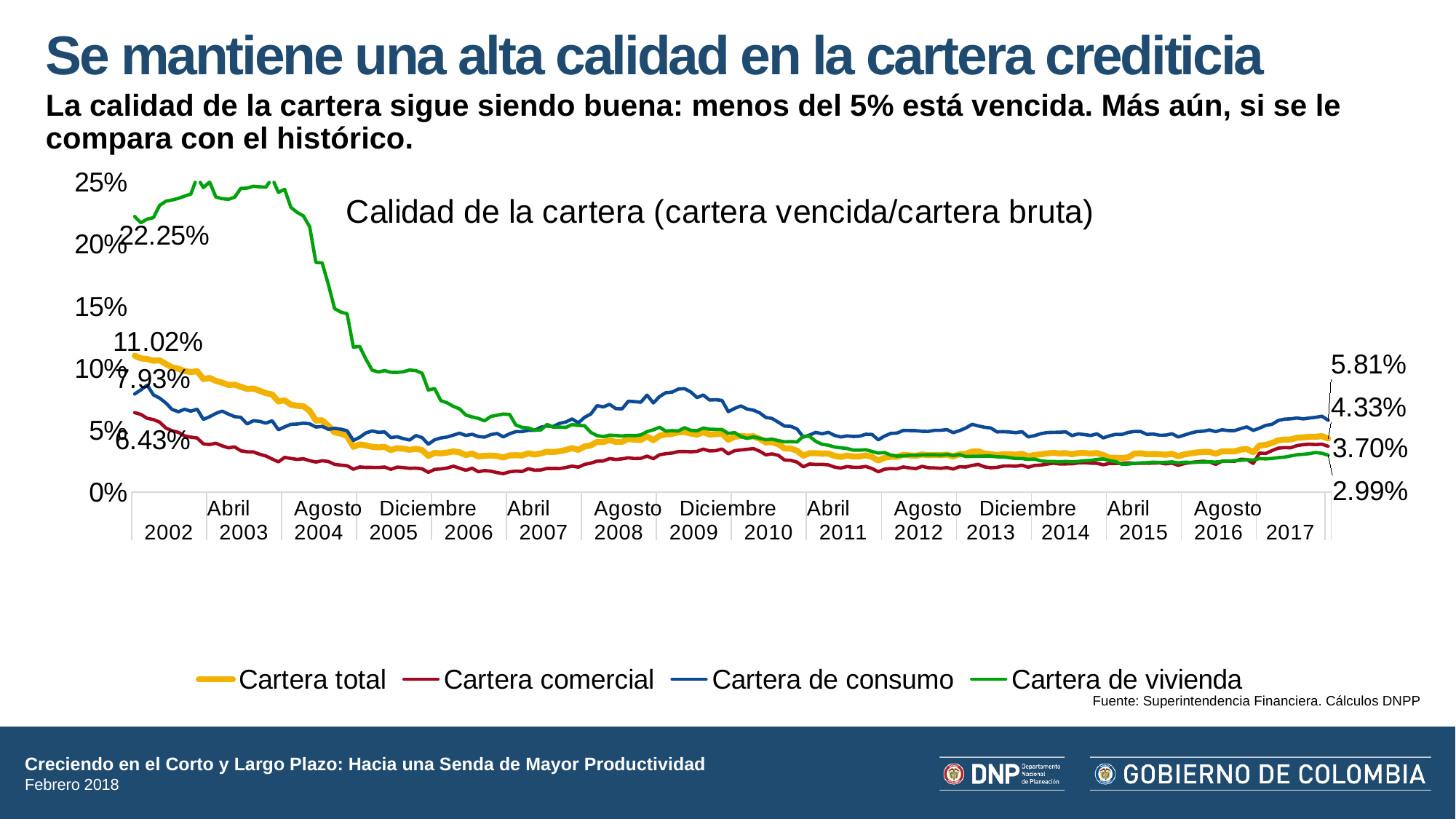
What is the value labelled at the end of the Cartera de vivienda series? 2.99% What is the title of the chart? Calidad de la cartera (cartera vencida/cartera bruta) At the start of the chart, which is larger: Cartera de consumo (7.93%) or Cartera comercial (6.43%)? Cartera de consumo How many series does the legend of the chart list? 4 Is the peak value of the Cartera de vivienda series around 2003 greater or less than 20%? greater What is the value labelled at the end of the Cartera de consumo series? 5.81% What is the value labelled at the start of the Cartera total series? 11.02% What is the value labelled at the start of the Cartera de vivienda series? 22.25% Which series has the lowest value at the end of the chart (2017)? Cartera de vivienda Which series has the highest value at the end of the chart (2017)? Cartera de consumo By how many percentage points did the Cartera de vivienda series fall from its labelled start value (22.25%) to its labelled end value (2.99%)? 19.26 percentage points What type of chart is shown on the slide? Line chart